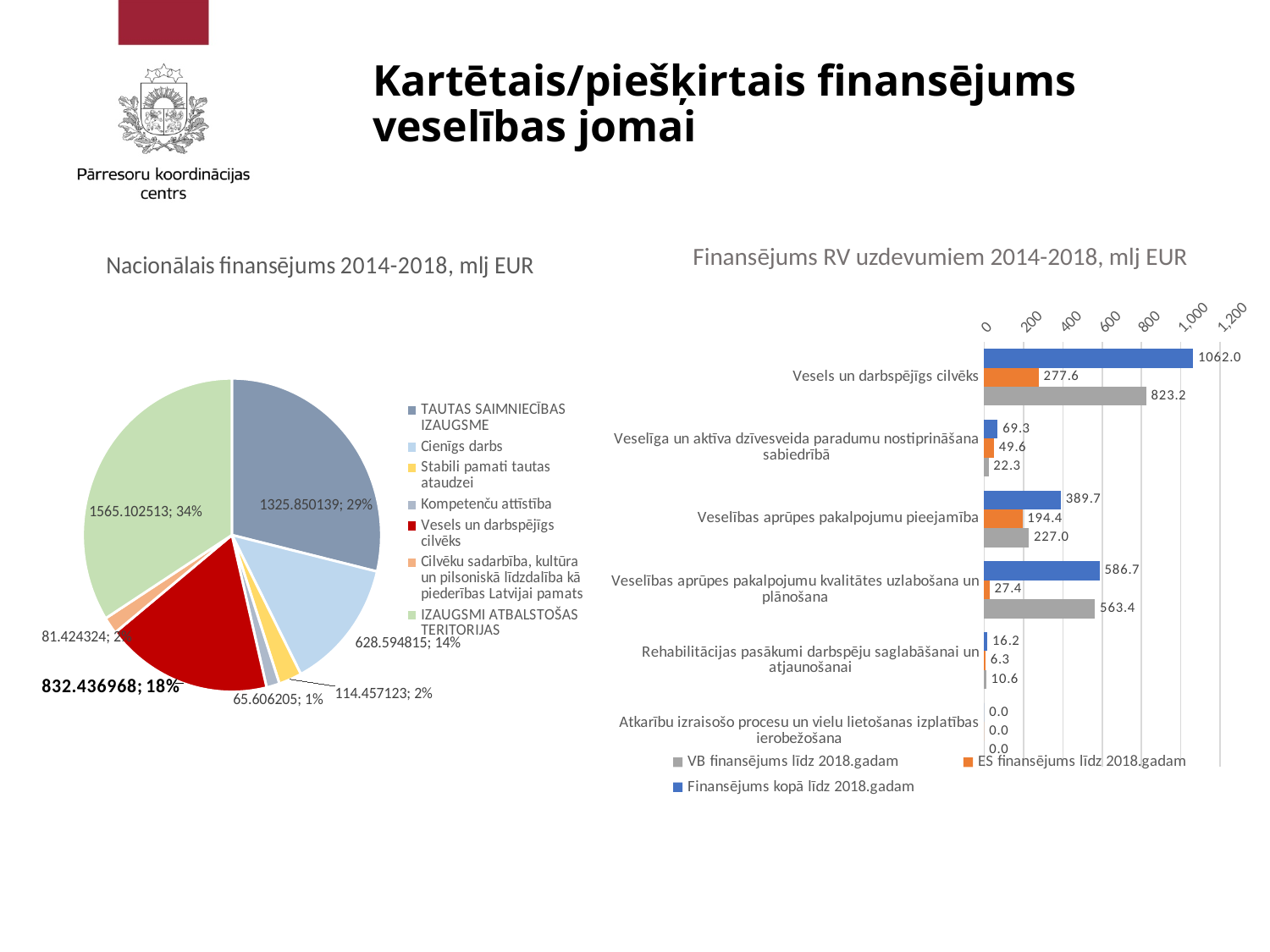
How many slices does the pie chart 'Nacionālais finansējums 2014-2018, mlj EUR' have? 7 In the bar chart 'Finansējums RV uzdevumiem 2014-2018, mlj EUR', what is the value of 'ES finansējums līdz 2018.gadam' for 'Veselības aprūpes pakalpojumu pieejamība'? 194.4 In the bar chart 'Finansējums RV uzdevumiem 2014-2018, mlj EUR', which category has the highest 'Finansējums kopā līdz 2018.gadam' value? Vesels un darbspējīgs cilvēks In the bar chart 'Finansējums RV uzdevumiem 2014-2018, mlj EUR', what is the value of 'Finansējums kopā līdz 2018.gadam' for 'Vesels un darbspējīgs cilvēks'? 1062.0 In the pie chart 'Nacionālais finansējums 2014-2018, mlj EUR', what share does the slice 'IZAUGSMI ATBALSTOŠAS TERITORIJAS' have? 34% In the bar chart 'Finansējums RV uzdevumiem 2014-2018, mlj EUR', what colour represents 'ES finansējums līdz 2018.gadam'? Orange In the pie chart 'Nacionālais finansējums 2014-2018, mlj EUR', which is larger: 'TAUTAS SAIMNIECĪBAS IZAUGSME' or 'Cienīgs darbs'? TAUTAS SAIMNIECĪBAS IZAUGSME What type of chart is 'Finansējums RV uzdevumiem 2014-2018, mlj EUR'? Bar chart In the pie chart 'Nacionālais finansējums 2014-2018, mlj EUR', what value is shown for 'Vesels un darbspējīgs cilvēks'? 832.436968 How many series does the legend of the bar chart 'Finansējums RV uzdevumiem 2014-2018, mlj EUR' list? 3 In the bar chart 'Finansējums RV uzdevumiem 2014-2018, mlj EUR', what is the difference between 'VB finansējums līdz 2018.gadam' and 'ES finansējums līdz 2018.gadam' for 'Veselības aprūpes pakalpojumu kvalitātes uzlabošana un plānošana'? 536.0 In the pie chart 'Nacionālais finansējums 2014-2018, mlj EUR', which slice is the smallest? Kompetenču attīstība